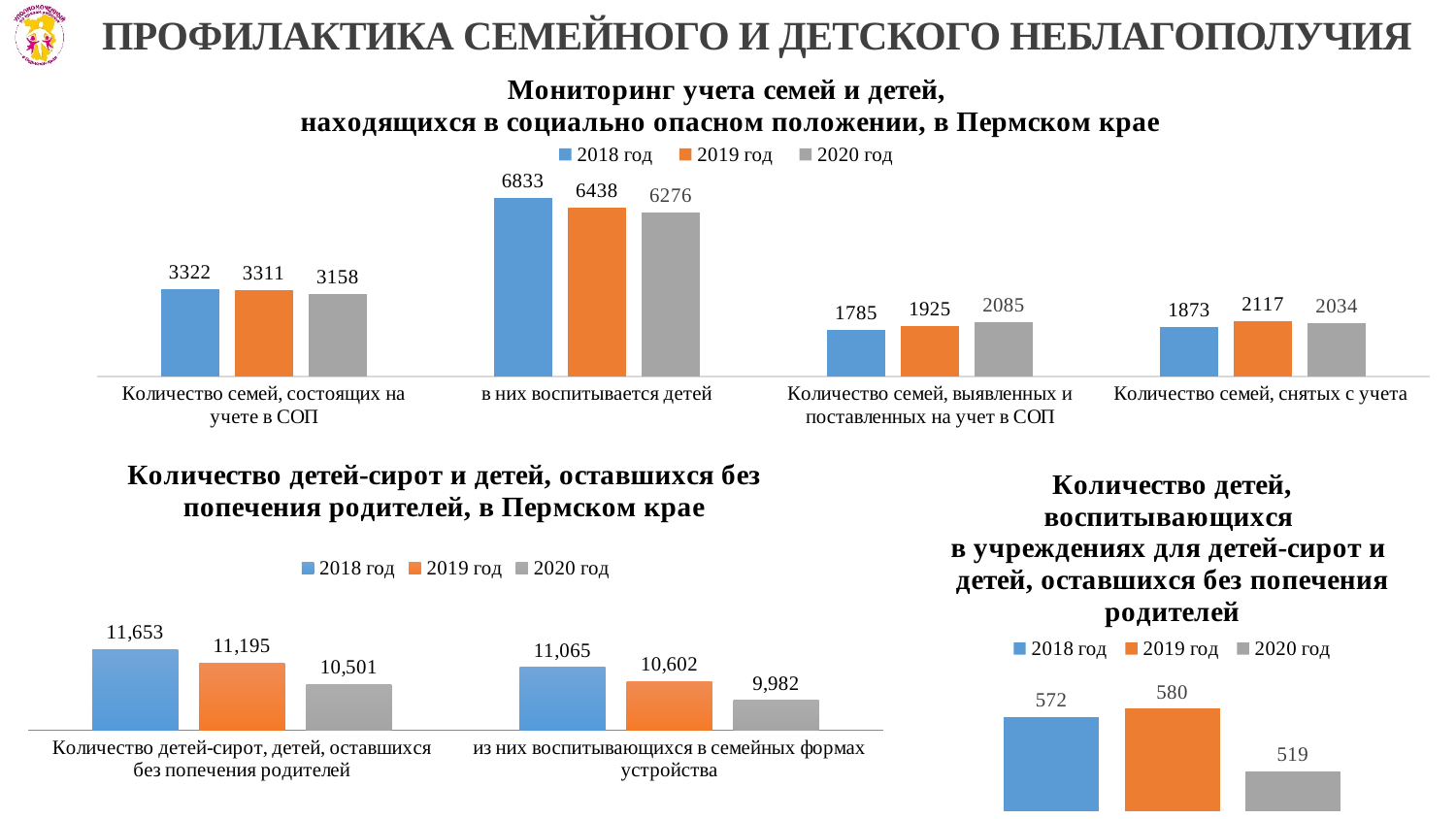
In the top chart (Мониторинг учета семей и детей), which year has the highest value in the category 'Количество семей, выявленных и поставленных на учет в СОП'? 2020 год In the top chart (Мониторинг учета семей и детей), what is the value for 2020 год in the category 'Количество семей, состоящих на учете в СОП'? 3158 In the bottom-left chart (Количество детей-сирот и детей, оставшихся без попечения родителей), what is the value for 2019 год in the category 'из них воспитывающихся в семейных формах устройства'? 10,602 What type of chart is the bottom-right chart (Количество детей, воспитывающихся в учреждениях для детей-сирот)? bar chart In the bottom-left chart (Количество детей-сирот и детей, оставшихся без попечения родителей), what is the difference between the 2018 год and 2020 год values for 'Количество детей-сирот, детей, оставшихся без попечения родителей'? 1,152 In the bottom-left chart (Количество детей-сирот и детей, оставшихся без попечения родителей), how many series does the legend list? 3 In the top chart (Мониторинг учета семей и детей), do the values for 'в них воспитывается детей' rise or fall from 2018 год to 2020 год? fall In the top chart (Мониторинг учета семей и детей), what is the difference between the 2019 год and 2020 год values for 'Количество семей, снятых с учета'? 83 In the bottom-right chart (Количество детей, воспитывающихся в учреждениях для детей-сирот), which is larger: the value for 2018 год or 2019 год? 2019 год In the bottom-right chart (Количество детей, воспитывающихся в учреждениях для детей-сирот), which year has the lowest value? 2020 год In the top chart (Мониторинг учета семей и детей), how many categories are shown on the x axis? 4 In the top chart (Мониторинг учета семей и детей), what is the value for 2018 год in the category 'в них воспитывается детей'? 6833